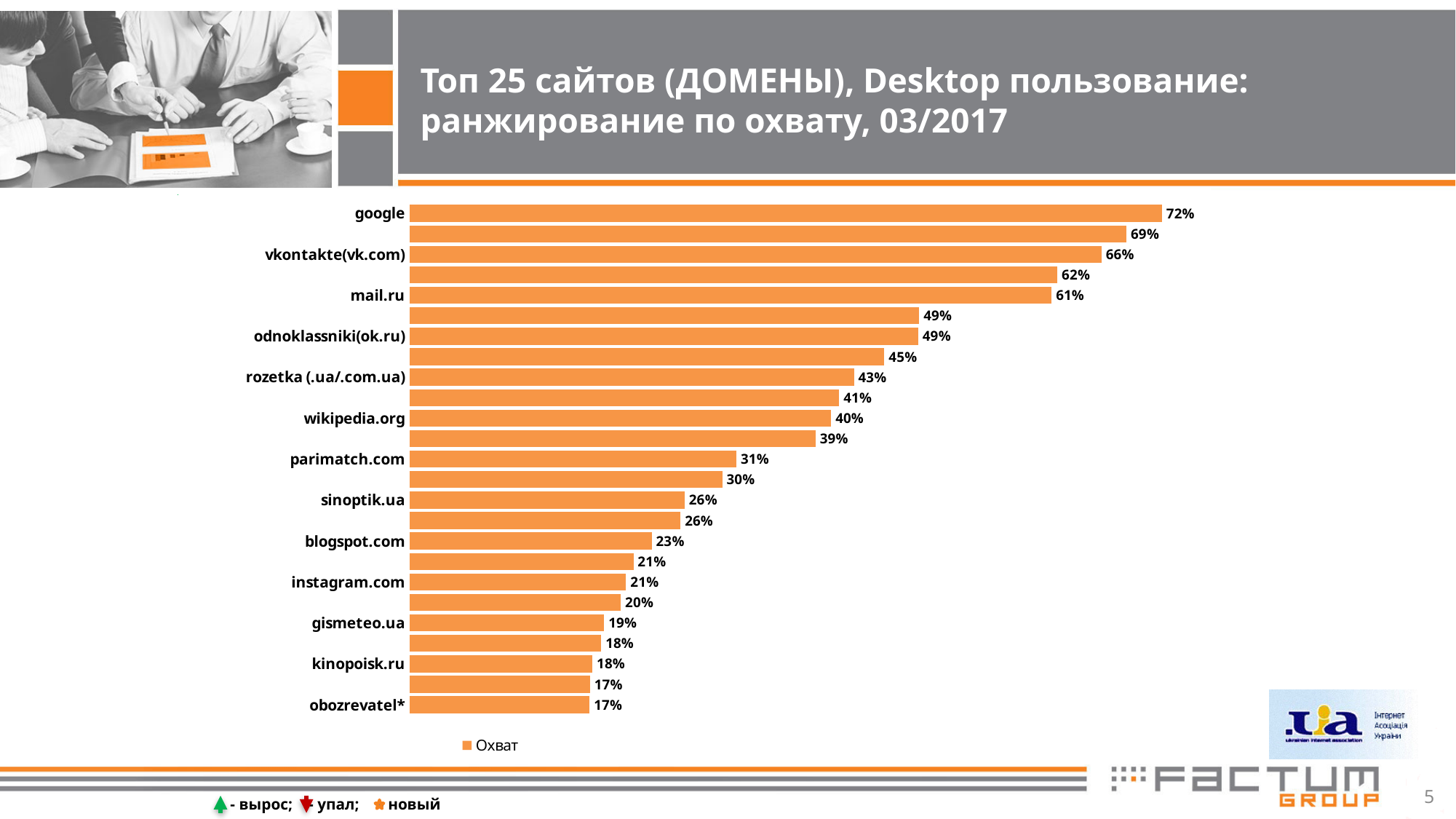
What is the value for google? 72% What is the value for rozetka (.ua/.com.ua)? 43% How many bars are plotted in the chart? 25 Which site has the highest value in the chart? google What is the value for vkontakte(vk.com)? 66% How many series does the legend list? 1 What is the value for mail.ru? 61% What is the value for sinoptik.ua? 26% Which has a larger value, wikipedia.org or parimatch.com? wikipedia.org What is the difference between the values for google and mail.ru? 11 percentage points What is the lowest value shown in the chart? 17% What kind of chart is shown on the slide? Bar chart